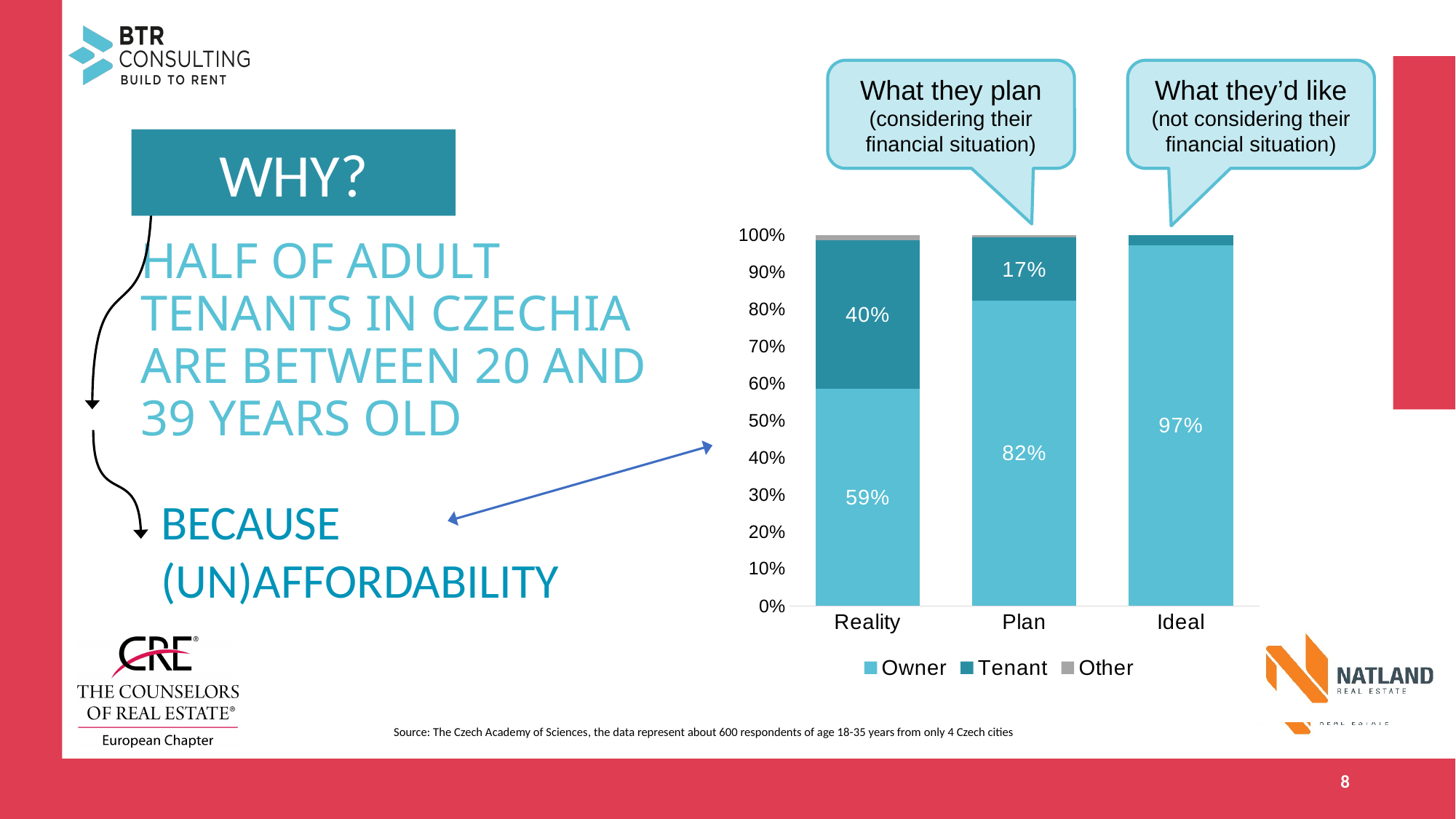
Which category has the highest Owner share? Ideal Which is larger, the Tenant share for Reality or the Tenant share for Plan? Reality Which category has the lowest Owner share? Reality Is the Tenant share for Ideal greater or less than 10%? less How many categories are shown on the x axis? 3 What is the difference between the Owner share for Plan and the Owner share for Reality? 23 percentage points What is the Owner share for Reality? 59% Does the Owner share rise or fall from Reality to Ideal? rise What is the Tenant share for Plan? 17% What is the Owner share for Ideal? 97% What is the Tenant share for Reality? 40% How many series does the legend list? 3